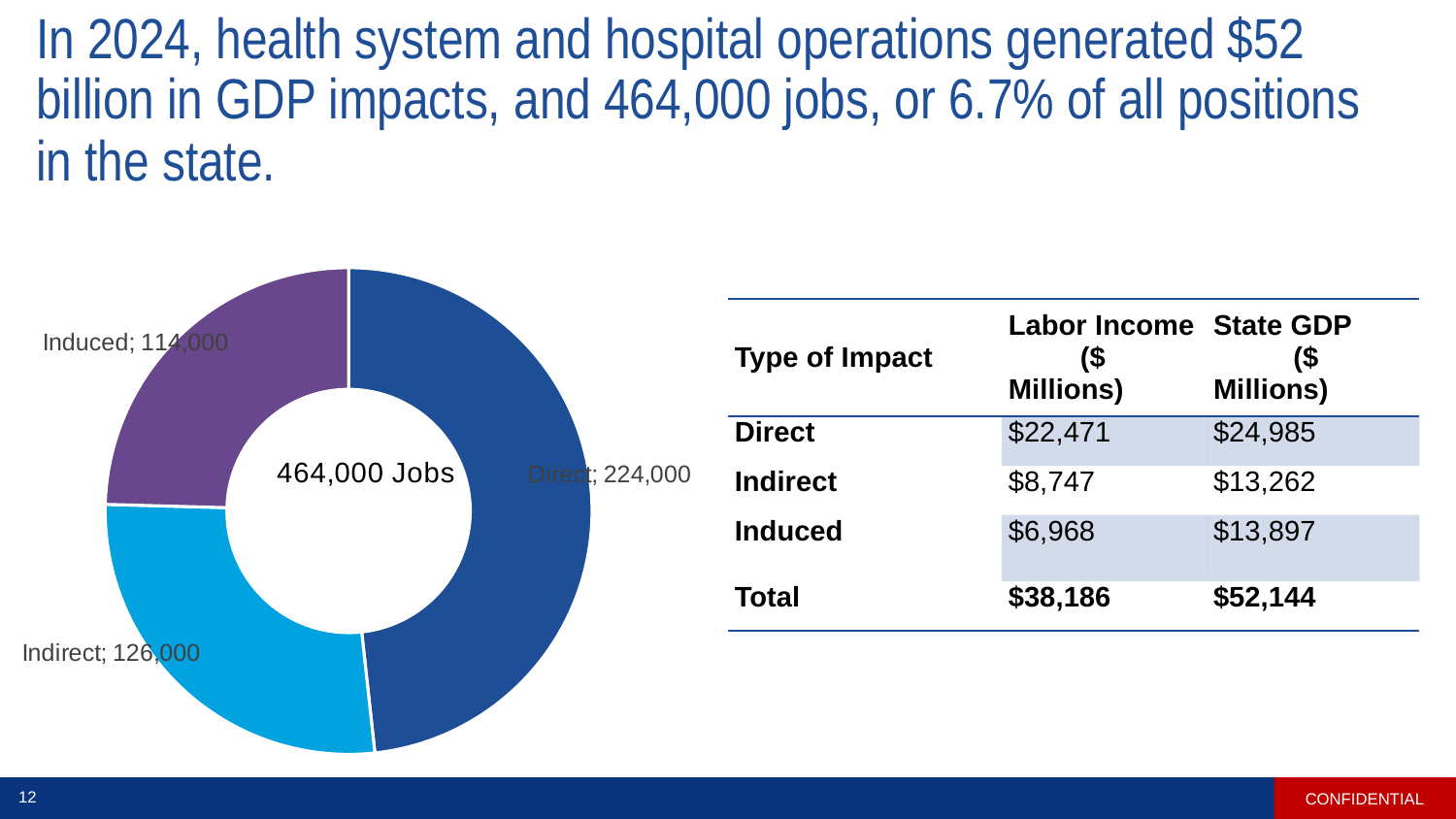
Which category in the donut chart has the smallest number of jobs? Induced Which category in the donut chart has the largest number of jobs? Direct What is the number of jobs for the Direct category in the donut chart? 224,000 What is the number of jobs for the Induced category in the donut chart? 114,000 What is the difference in jobs between the Indirect and Induced categories in the donut chart? 12,000 Which has more jobs in the donut chart, Indirect or Induced? Indirect What is the difference in jobs between the Direct and Indirect categories in the donut chart? 98,000 What colour is the Direct slice in the donut chart? dark blue What is the number of jobs for the Indirect category in the donut chart? 126,000 What kind of chart is shown on the left of the slide? donut chart What total number of jobs is shown in the center of the donut chart? 464,000 Jobs How many categories does the donut chart show? 3